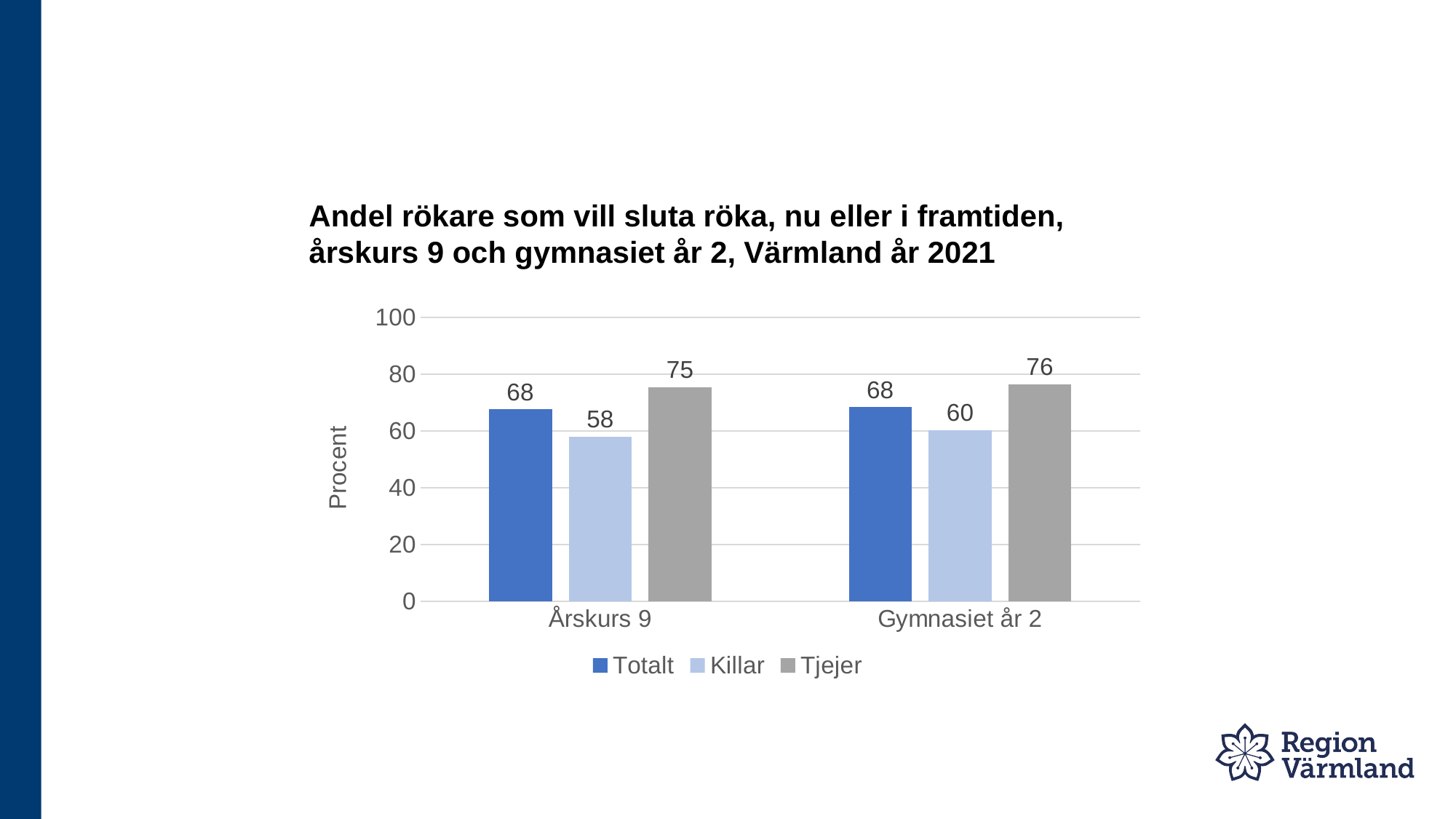
What is the value for Totalt in Gymnasiet år 2? 68 How many series does the legend list? 3 What is the value for Tjejer in Gymnasiet år 2? 76 What is the difference between Tjejer and Killar in Årskurs 9? 17 Which is larger: Tjejer in Årskurs 9 or Killar in Gymnasiet år 2? Tjejer in Årskurs 9 Which series has the lowest value in Gymnasiet år 2? Killar What kind of chart is shown on the slide? Bar chart How many categories are shown on the x axis? 2 What is the value for Killar in Årskurs 9? 58 What is the label of the y axis? Procent Which series has the highest value in Årskurs 9? Tjejer What is the difference between Killar in Gymnasiet år 2 and Killar in Årskurs 9? 2